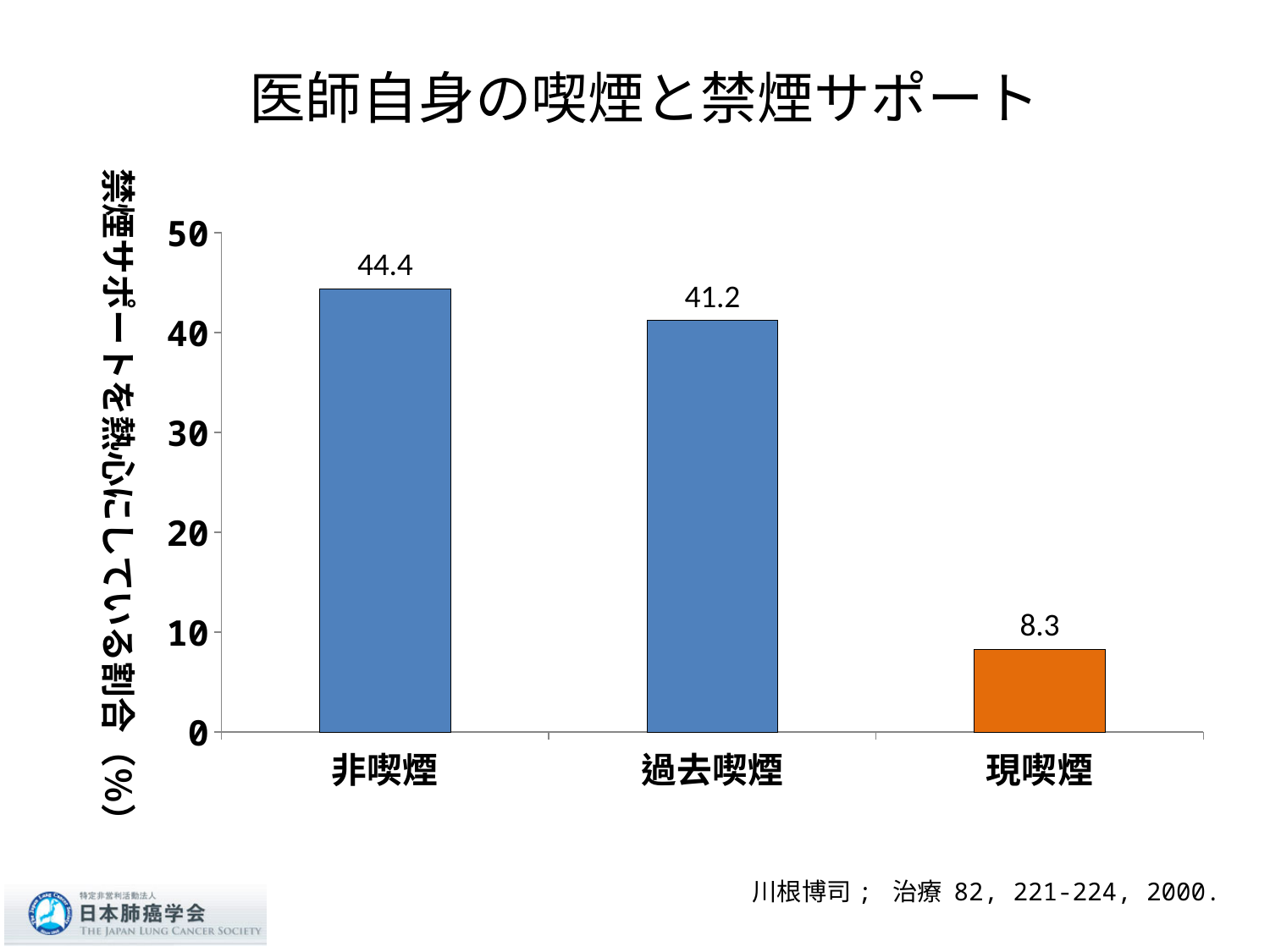
What is the value for 現喫煙? 8.3 Which is larger, the value for 過去喫煙 or the value for 現喫煙? 過去喫煙 How many categories are shown on the x axis? 3 Which category has the lowest value? 現喫煙 What is the difference between the values for 非喫煙 and 過去喫煙? 3.2 What is the value for 過去喫煙? 41.2 What kind of chart is shown on the slide? bar chart Is the value for 現喫煙 greater or less than 10? less What is the value for 非喫煙? 44.4 Which category has the highest value? 非喫煙 Which bar is coloured orange rather than blue? 現喫煙 What is the difference between the values for 非喫煙 and 現喫煙? 36.1